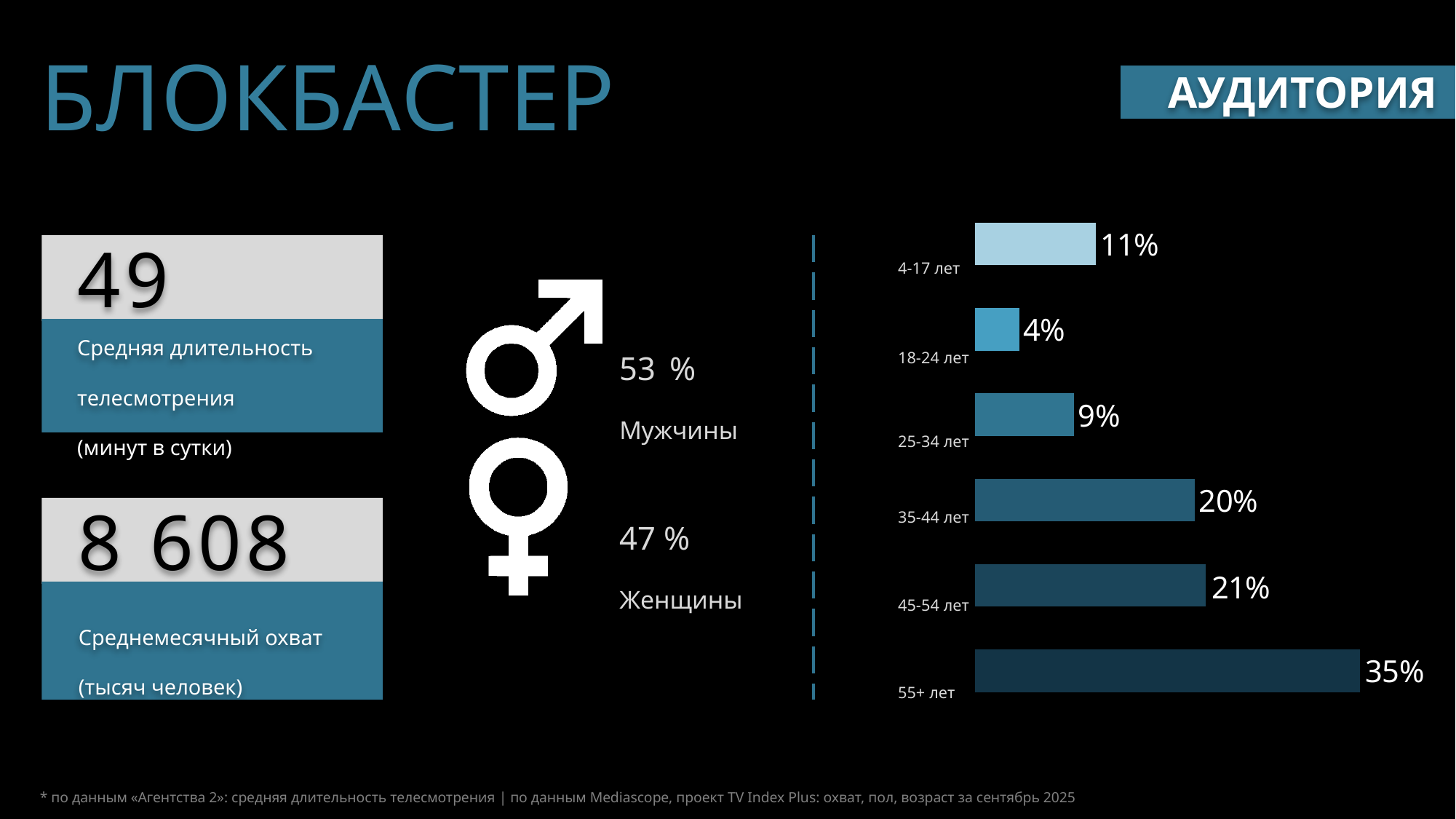
What is the value for the 18-24 лет age group in the bar chart? 4% What is the total of the values for 45-54 лет and 55+ лет in the bar chart? 56% What is the value for the 4-17 лет age group in the bar chart? 11% What is the difference between the values for 4-17 лет and 25-34 лет in the bar chart? 2% How many age groups are shown in the bar chart? 6 What kind of chart is used to show the age groups on the slide? Bar chart What is the value for the 55+ лет age group in the bar chart? 35% What is the value for the 35-44 лет age group in the bar chart? 20% Which age group has the lowest value in the bar chart? 18-24 лет Which age group has the highest value in the bar chart? 55+ лет What is the difference between the values for 55+ лет and 45-54 лет in the bar chart? 14% Which is larger in the bar chart: the value for 35-44 лет or the value for 25-34 лет? 35-44 лет